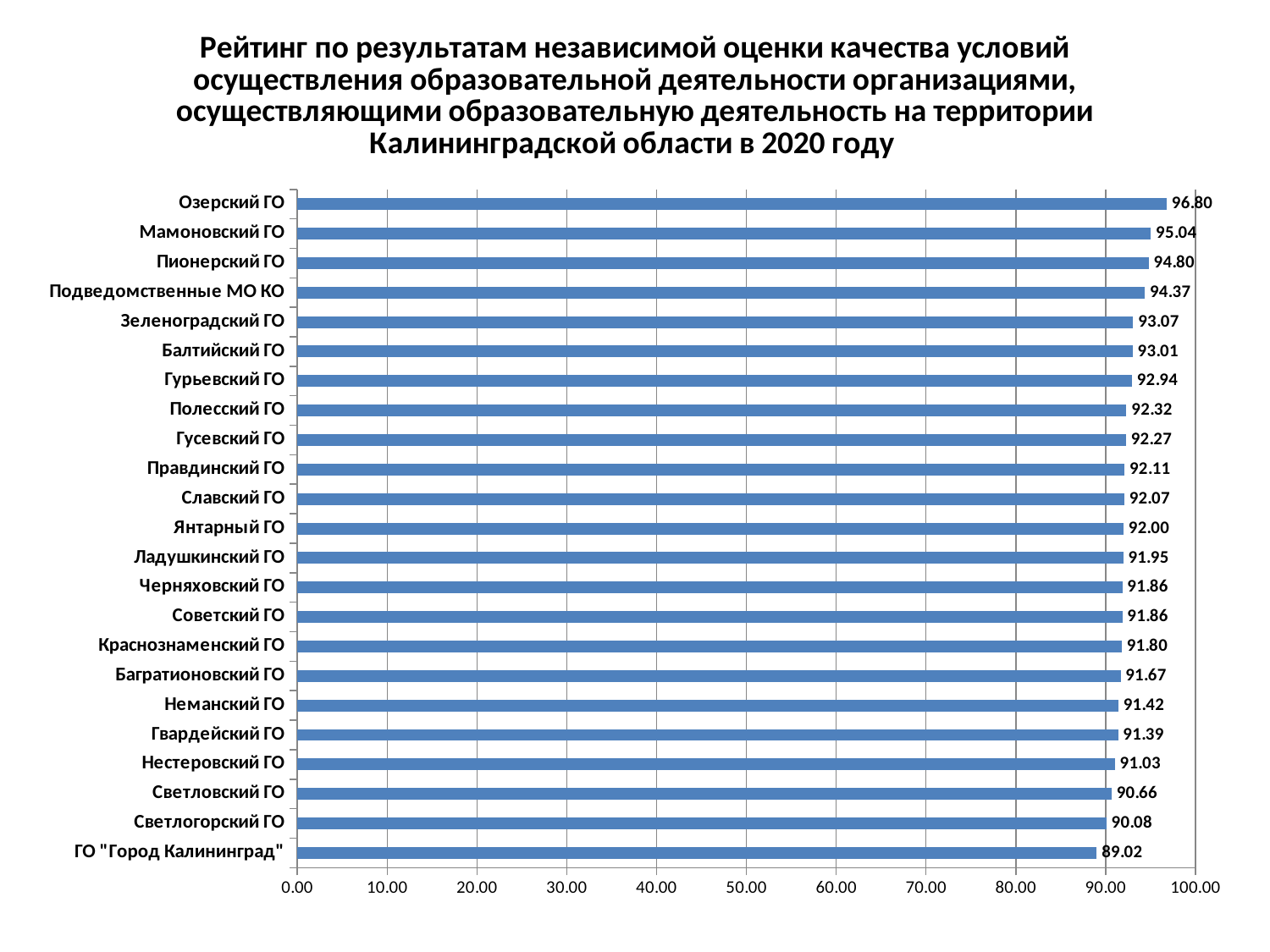
How many categories are shown in the chart? 23 Which category has the highest value? Озерский ГО Which is larger, the value for Мамоновский ГО or the value for Светловский ГО? Мамоновский ГО Which category has the lowest value? ГО "Город Калининград" Is the value for Гвардейский ГО greater or less than 90.00? greater What is the value for ГО "Город Калининград"? 89.02 What is the value for Подведомственные МО КО? 94.37 What is the difference between the values for Зеленоградский ГО and Светлогорский ГО? 2.99 What is the difference between the values for Озерский ГО and ГО "Город Калининград"? 7.78 What is the value for Озерский ГО? 96.80 What kind of chart is shown on the slide? bar chart What is the value for Нестеровский ГО? 91.03